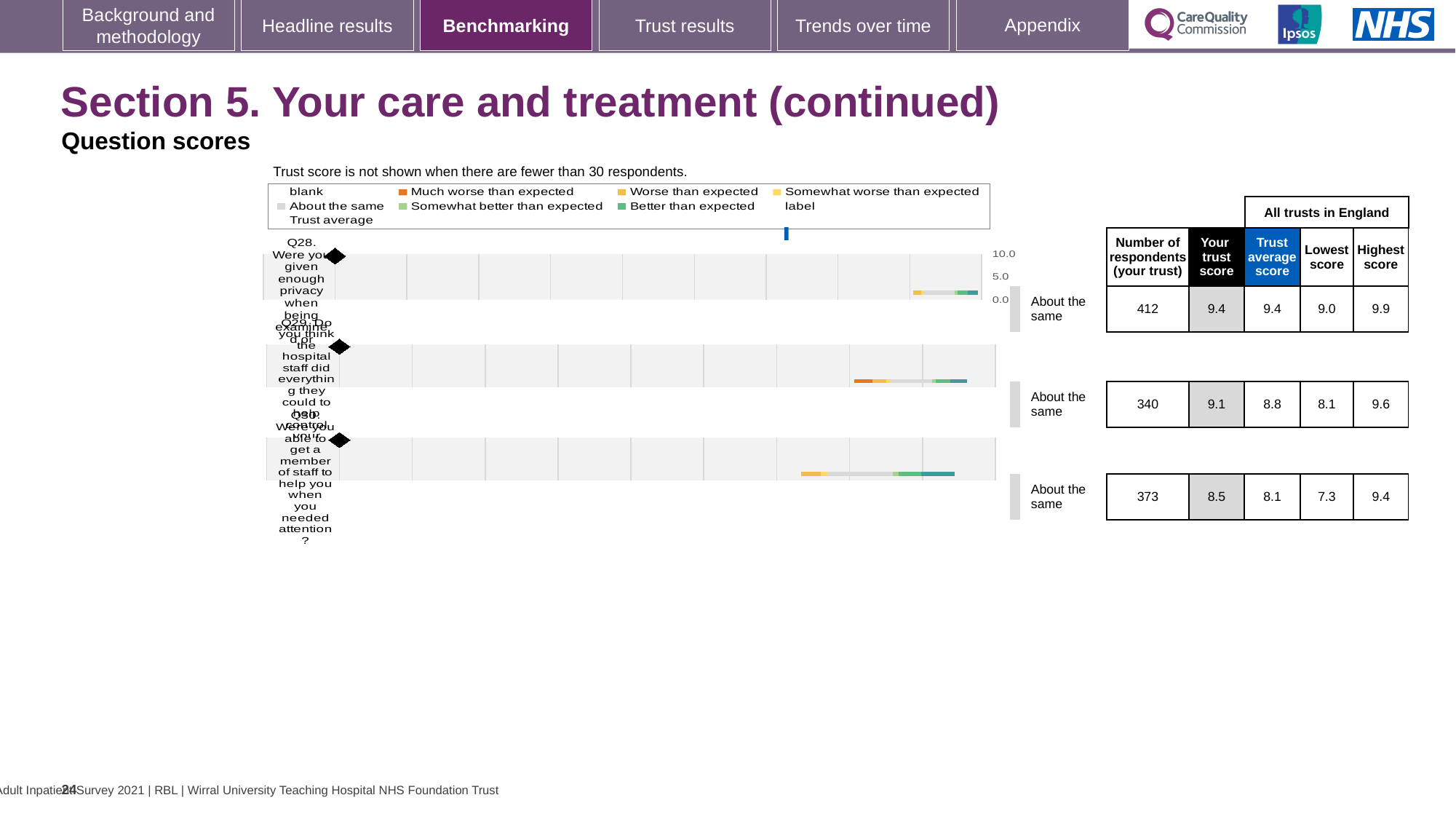
For the Q30 chart (getting a member of staff to help when needed), what is the highest score across all trusts in England? 9.4 For the Q29 chart, what is the difference between 'Your trust score' and the 'Trust average score'? 0.3 Which question's chart has the highest 'Your trust score' on this slide? Q28 For the Q30 chart, which is larger: 'Your trust score' or the 'Trust average score'? Your trust score Which question's chart has the lowest 'Your trust score' on this slide? Q30 What kind of chart is used to show the benchmarking results for Q28, Q29 and Q30? bar chart How many questions (Q28, Q29, Q30) have benchmarking charts on this slide? 3 What benchmark category is shown next to the Q28 chart? About the same For the Q30 chart, what is the difference between the highest score and the lowest score across all trusts in England? 2.1 For the Q28 chart, what is the lowest score across all trusts in England? 9.0 For the Q29 chart (staff did everything to help control pain), how many respondents are shown for your trust? 340 For the Q28 chart (privacy when being examined), what is the 'Your trust score' value? 9.4